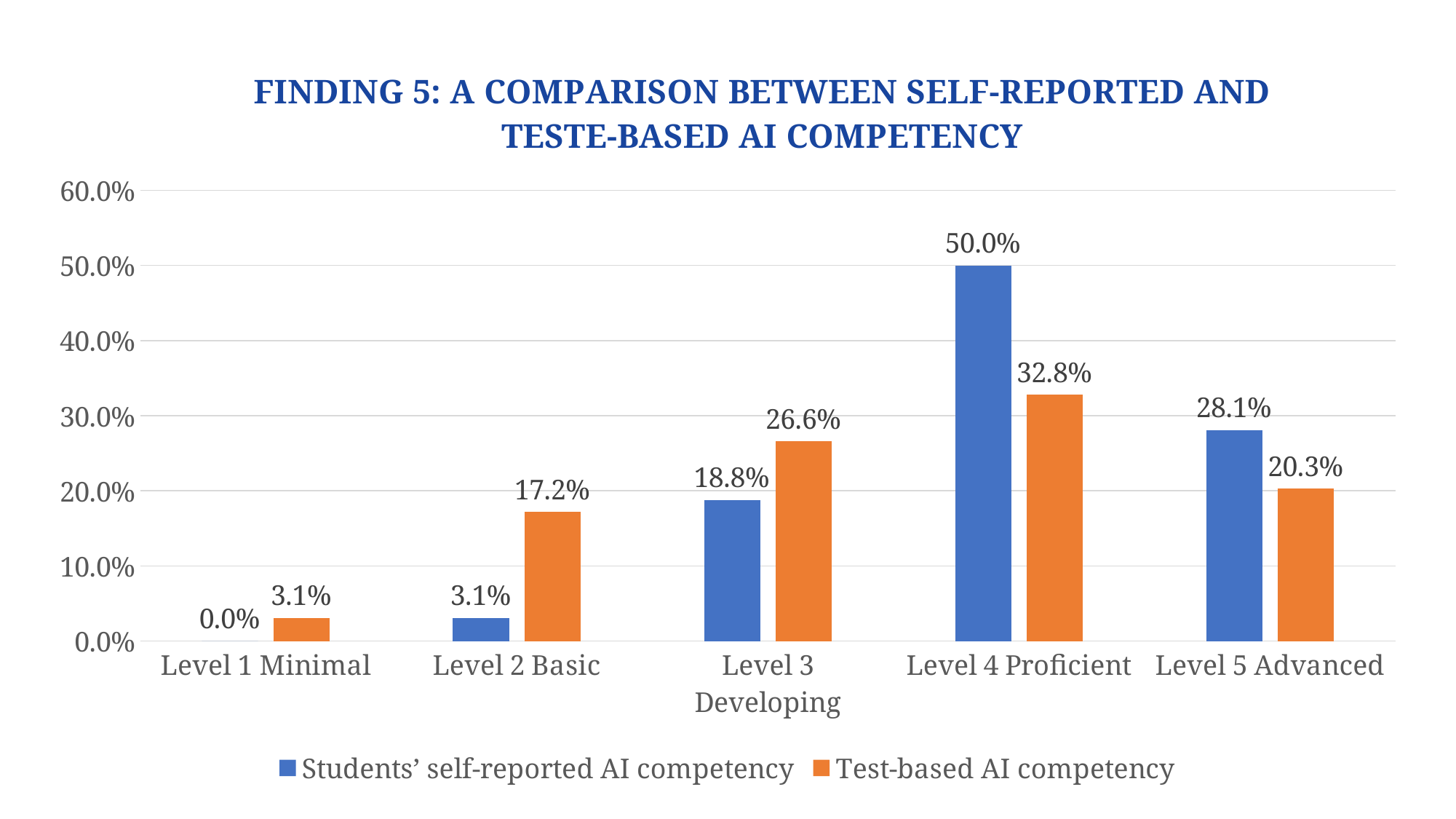
Which level has the lowest students' self-reported AI competency value? Level 1 Minimal For Level 3 Developing, which is larger: the self-reported or the test-based AI competency value? Test-based AI competency How many series does the legend list? 2 Which colour represents test-based AI competency in the chart? Orange How many competency levels are shown on the x axis? 5 What is the test-based AI competency value for Level 3 Developing? 26.6% Which level has the highest test-based AI competency value? Level 4 Proficient What is the students' self-reported AI competency value for Level 1 Minimal? 0.0% What is the difference between the self-reported and test-based AI competency values for Level 4 Proficient? 17.2% What kind of chart is shown on the slide? Bar chart What is the test-based AI competency value for Level 5 Advanced? 20.3% What is the students' self-reported AI competency value for Level 4 Proficient? 50.0%